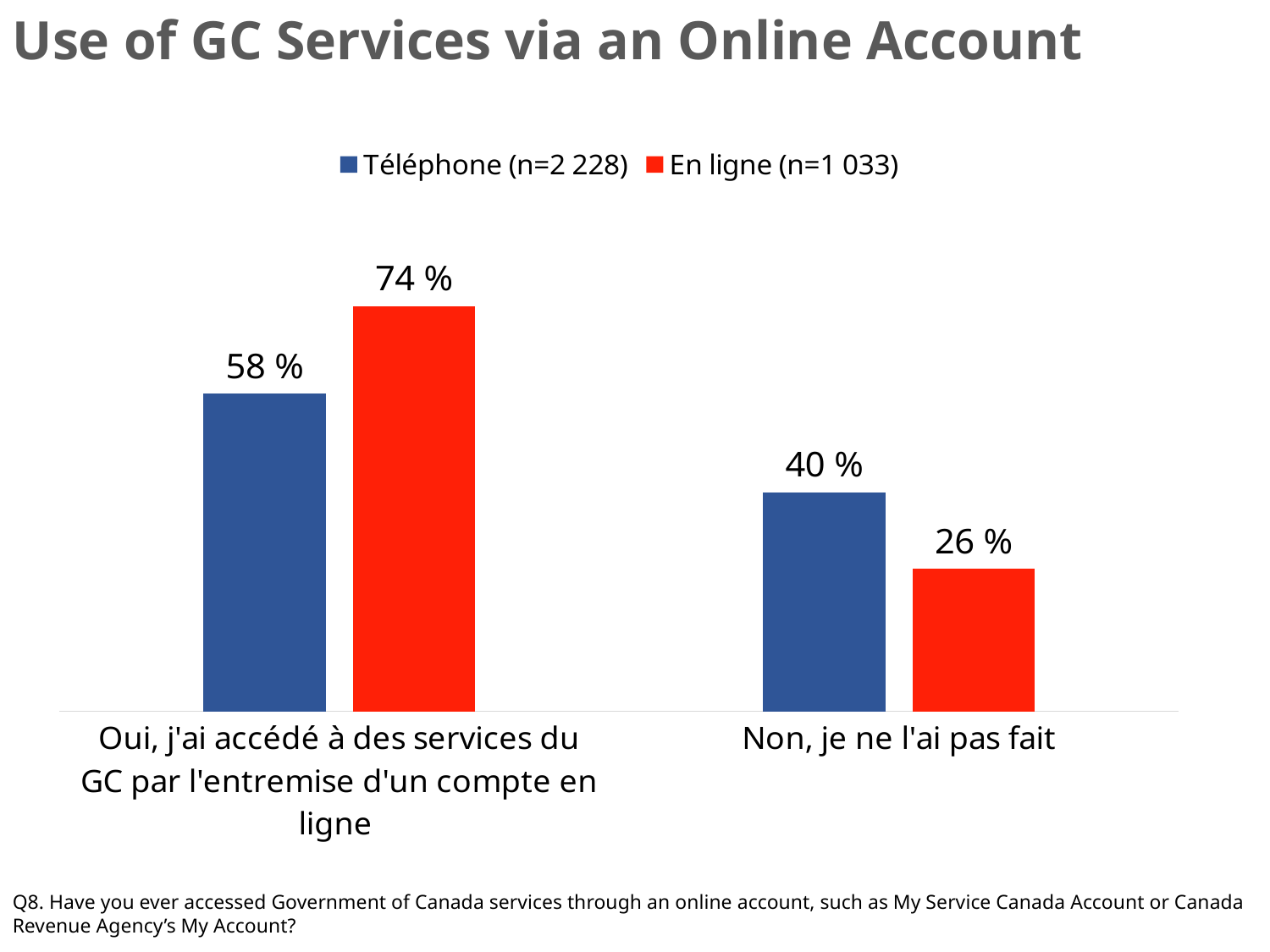
Which series has the lowest value in the category "Non, je ne l'ai pas fait"? En ligne (n=1 033) How many series does the legend list? 2 What is the value for Téléphone (n=2 228) in the category "Non, je ne l'ai pas fait"? 40 % What is the value for Téléphone (n=2 228) in the category "Oui, j'ai accédé à des services du GC par l'entremise d'un compte en ligne"? 58 % How many categories are shown on the x axis? 2 What kind of chart is shown on the slide? Bar chart What is the difference between the En ligne and Téléphone values for "Oui, j'ai accédé à des services du GC par l'entremise d'un compte en ligne"? 16 % What is the value for En ligne (n=1 033) in the category "Non, je ne l'ai pas fait"? 26 % What is the difference between the Téléphone and En ligne values for "Non, je ne l'ai pas fait"? 14 % Which series has the highest value in the category "Oui, j'ai accédé à des services du GC par l'entremise d'un compte en ligne"? En ligne (n=1 033) Which is larger for Téléphone (n=2 228): the value for "Oui, j'ai accédé à des services du GC par l'entremise d'un compte en ligne" or for "Non, je ne l'ai pas fait"? Oui, j'ai accédé à des services du GC par l'entremise d'un compte en ligne What is the value for En ligne (n=1 033) in the category "Oui, j'ai accédé à des services du GC par l'entremise d'un compte en ligne"? 74 %